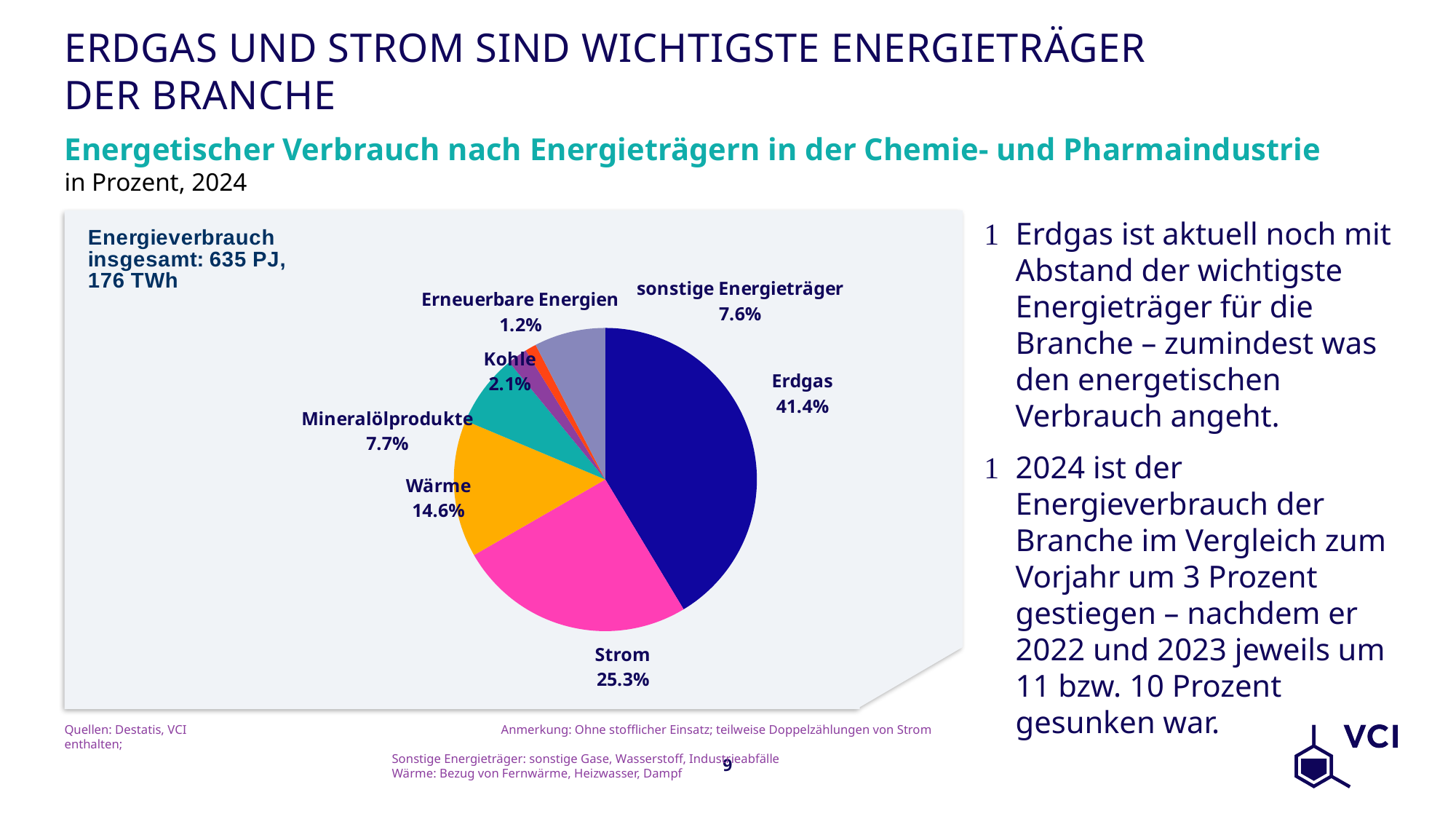
What is the difference in percentage points between Erdgas and Strom? 16.1 Which is larger, the share for Mineralölprodukte or the share for sonstige Energieträger? Mineralölprodukte What percentage is shown for Wärme? 14.6% Which energy source has the smallest slice of the pie? Erneuerbare Energien What is the value shown for Strom? 25.3% What is the value for Mineralölprodukte? 7.7% What share is shown for Kohle? 2.1% What share of energy consumption does Erdgas account for? 41.4% What total energy consumption is stated in the chart box? 635 PJ, 176 TWh What type of chart is shown on the slide? Pie chart Which energy source has the largest slice of the pie? Erdgas How many energy sources are shown in the pie chart? 7